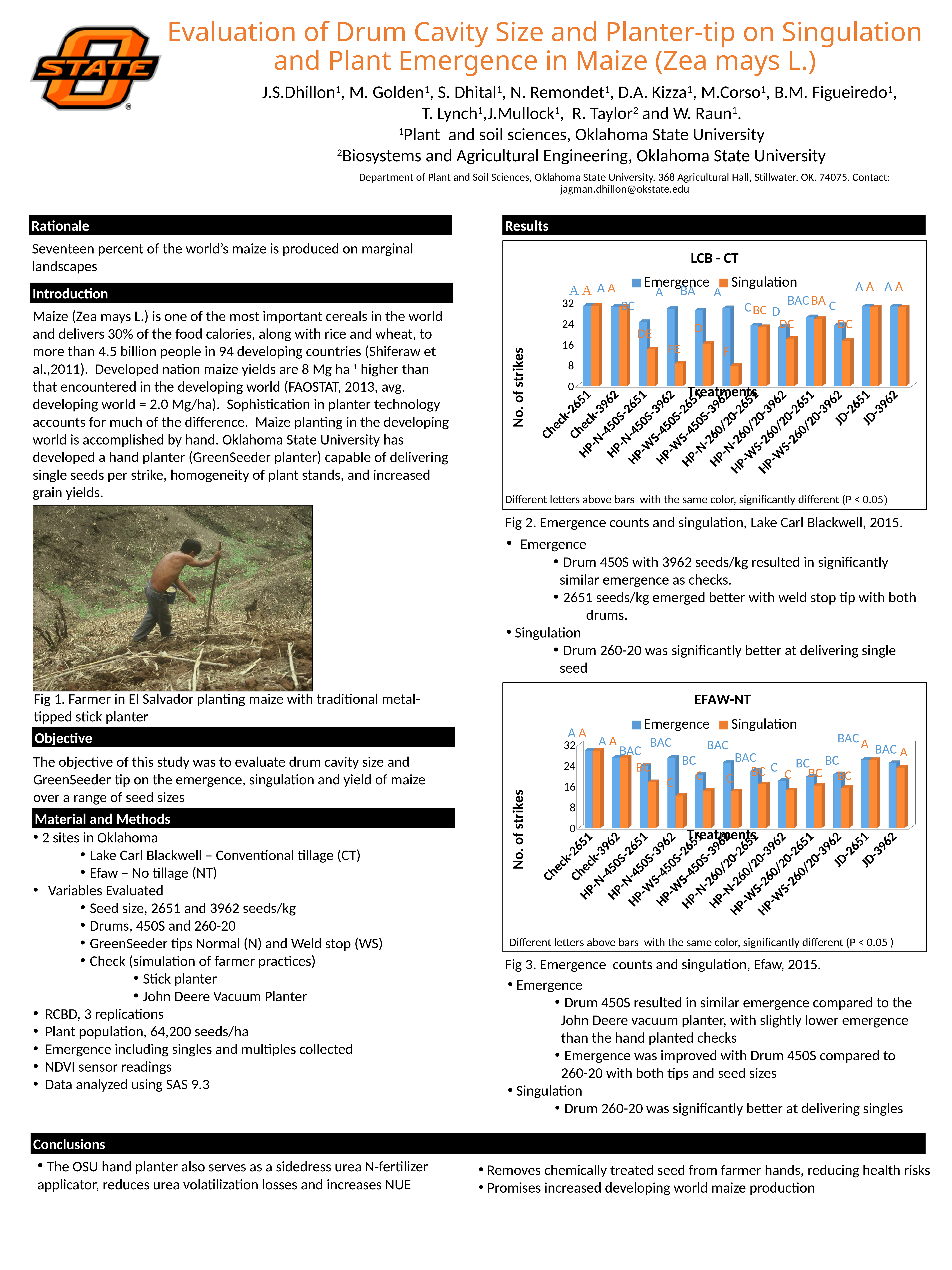
What kind of chart is the LCB - CT chart? bar chart In the EFAW-NT chart, which is larger for HP-WS-450S-2651, Emergence or Singulation? Emergence In the LCB - CT chart, is the Emergence value for Check-2651 greater or less than 24? greater How many series does the legend of the EFAW-NT chart list? 2 How many treatment categories are shown on the x axis of the LCB - CT chart? 12 In the EFAW-NT chart, is the Singulation value for HP-N-450S-3962 greater or less than 16? less What is the y-axis label of the LCB - CT chart? No. of strikes In the LCB - CT chart, which is larger for HP-N-450S-3962, Emergence or Singulation? Emergence In the EFAW-NT chart, is the Emergence value for HP-N-260/20-3962 greater or less than 24? less In the EFAW-NT chart, which colour represents the Singulation series? orange